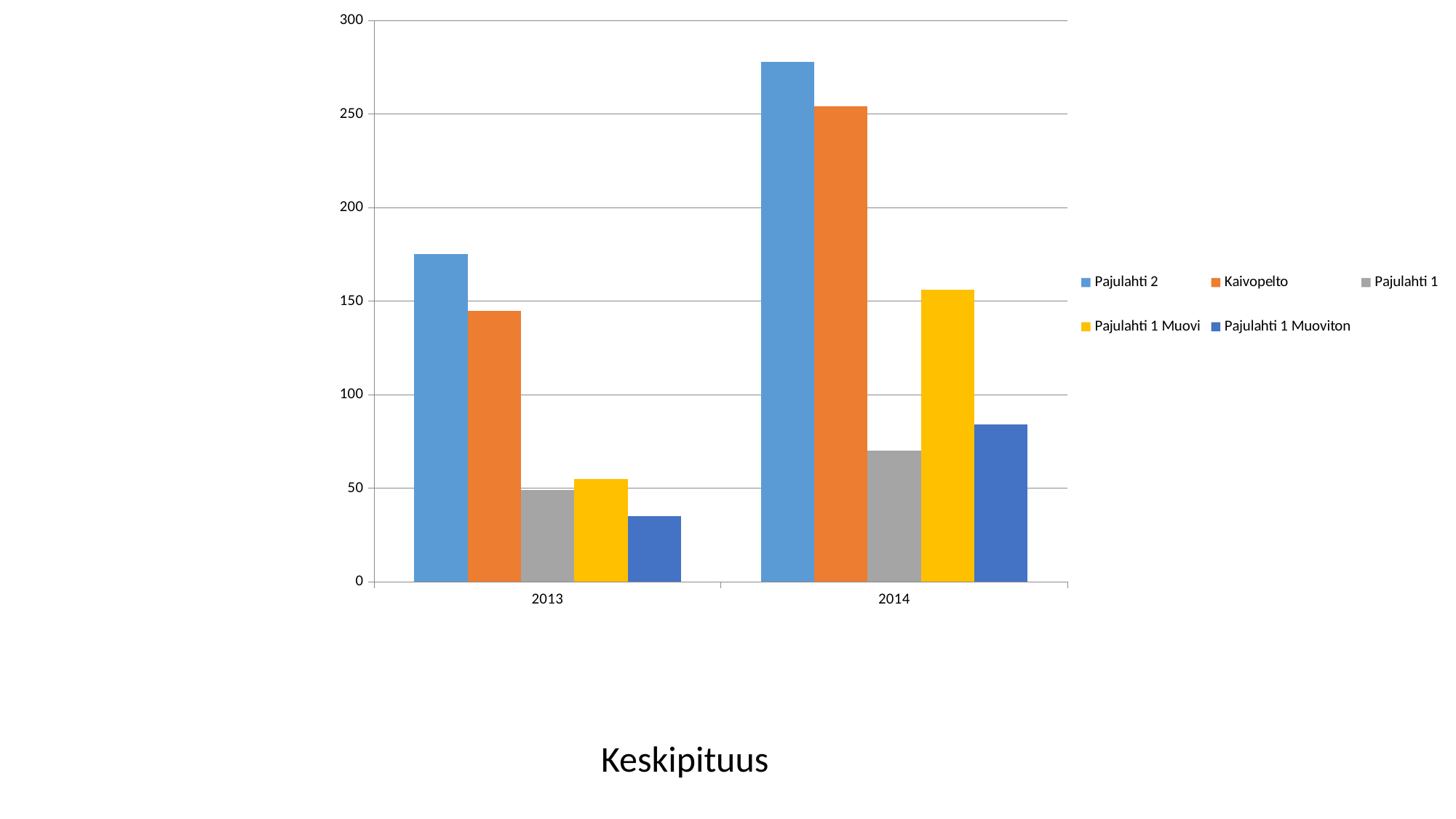
Which series has the lowest value in 2014? Pajulahti 1 How many categories are shown on the x axis? 2 Does the value for Kaivopelto rise or fall from 2013 to 2014? rise What kind of chart is shown on the slide? bar chart Is the value for Pajulahti 2 in 2013 greater or less than 150? greater Is the value for Pajulahti 1 Muoviton in 2014 greater or less than 100? less Which series has the highest value in 2014? Pajulahti 2 Which series has the highest value in 2013? Pajulahti 2 How many series does the legend list? 5 Is the value for Pajulahti 2 in 2014 greater or less than 250? greater Which series has the lowest value in 2013? Pajulahti 1 Muoviton In 2014, which is larger: Kaivopelto or Pajulahti 1 Muovi? Kaivopelto